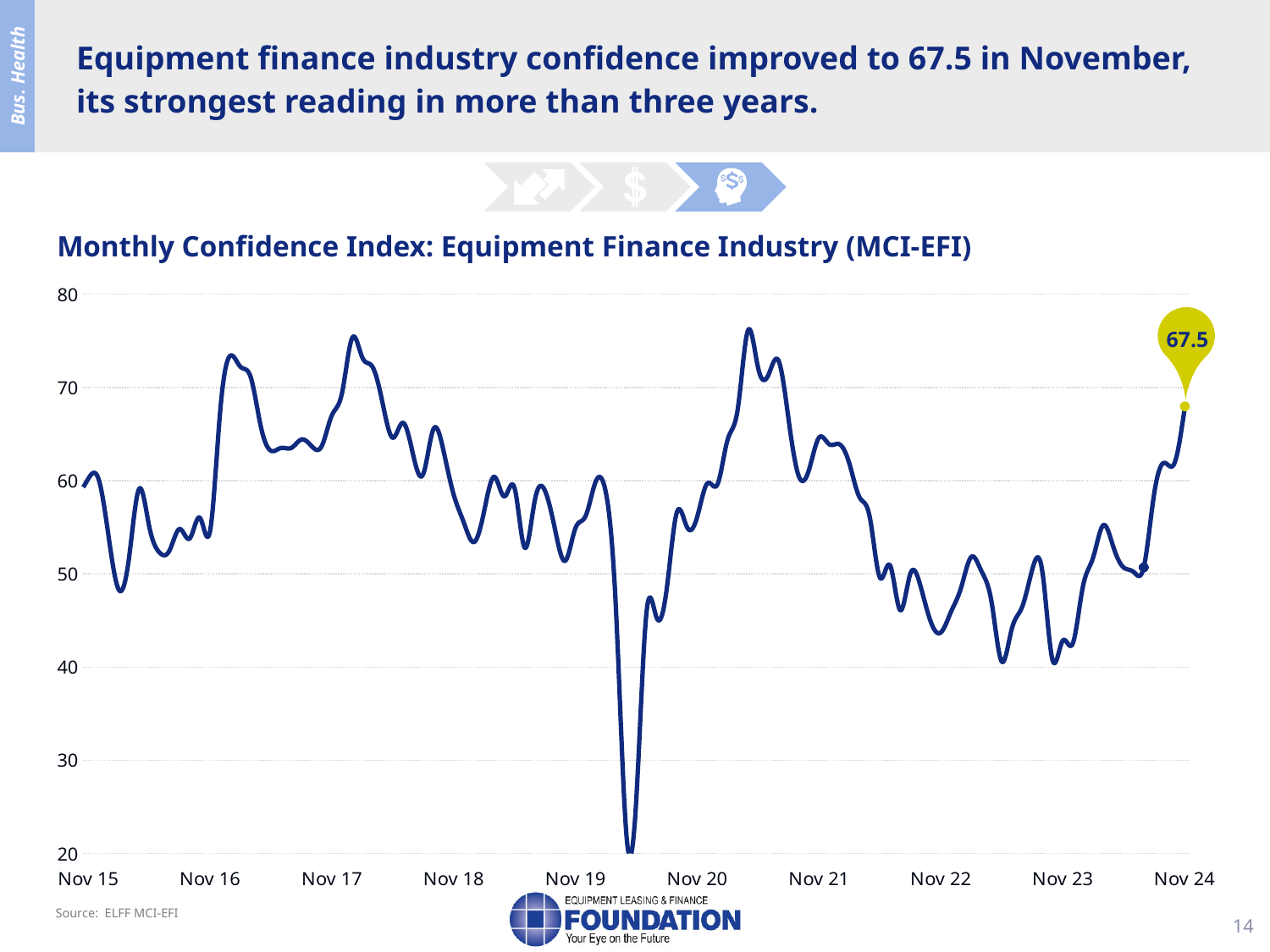
Is the highest point on the line greater or less than 70? greater Is the value at Nov 17 greater or less than 60? greater What source is cited for the chart? ELFF MCI-EFI What kind of chart is used to show the Monthly Confidence Index? Line chart Does the index rise or fall between Nov 23 and Nov 24? rise What are the minimum and maximum values shown on the y axis? 20 and 80 What is the value of the Monthly Confidence Index at Nov 24? 67.5 Is the value at Nov 22 greater or less than 50? less What is the title of the chart? Monthly Confidence Index: Equipment Finance Industry (MCI-EFI) Which is larger, the value at Nov 21 or the value at Nov 22? Nov 21 How many labelled tick marks are on the x axis? 10